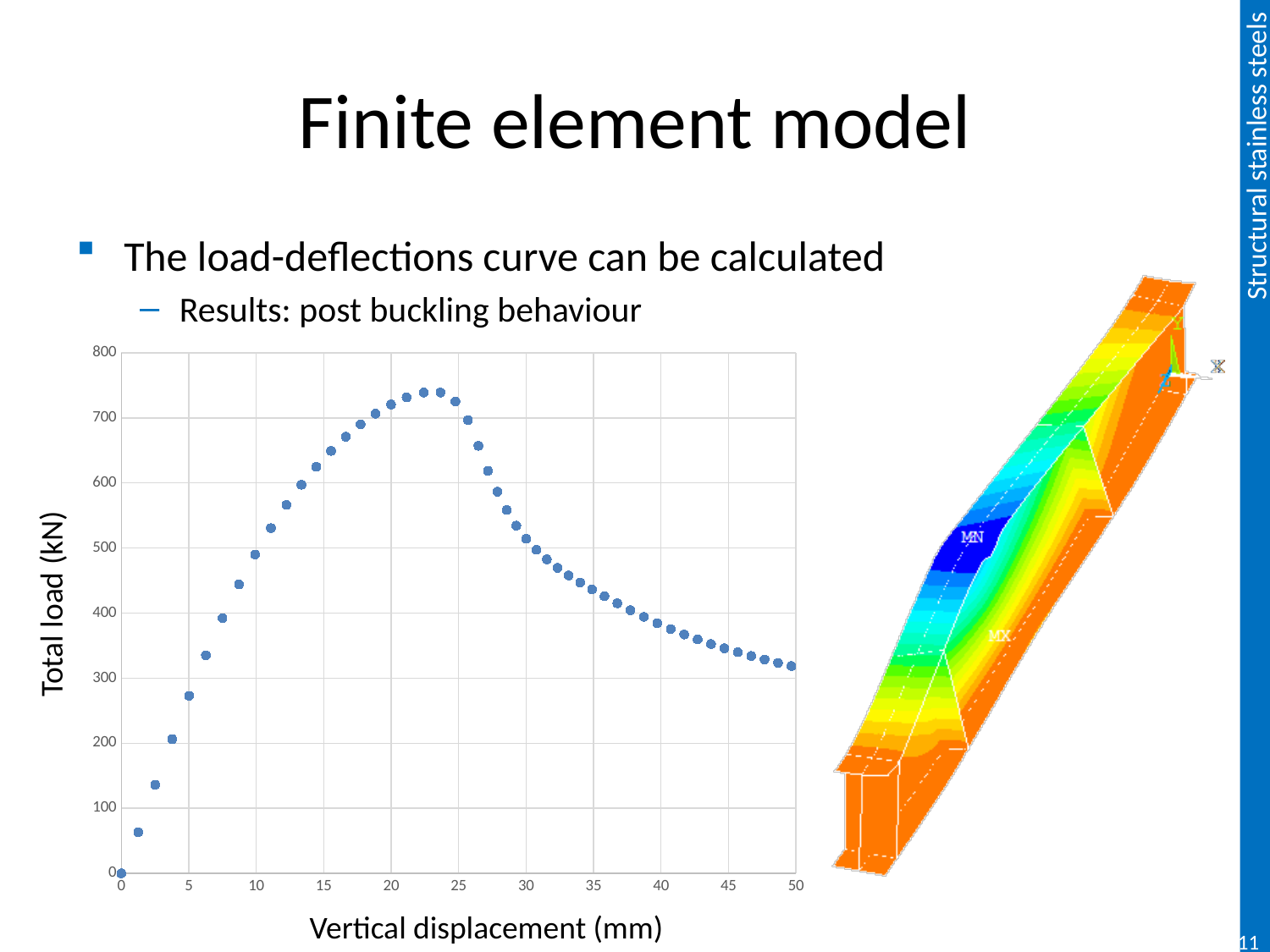
Is the total load at a vertical displacement of 5 mm greater or less than 300 kN? less Is the total load at a vertical displacement of 10 mm greater or less than 400 kN? greater What is the total load at a vertical displacement of 0 mm? 0 Is the total load at a vertical displacement of 50 mm greater or less than 300 kN? greater What kind of chart is shown on the slide? scatter chart Does the total load rise or fall as the vertical displacement increases from 0 mm to 20 mm? rise What is the title of the horizontal axis of the chart? Vertical displacement (mm) What is the title of the vertical axis of the chart? Total load (kN) Does the total load rise or fall as the vertical displacement increases from 30 mm to 50 mm? fall